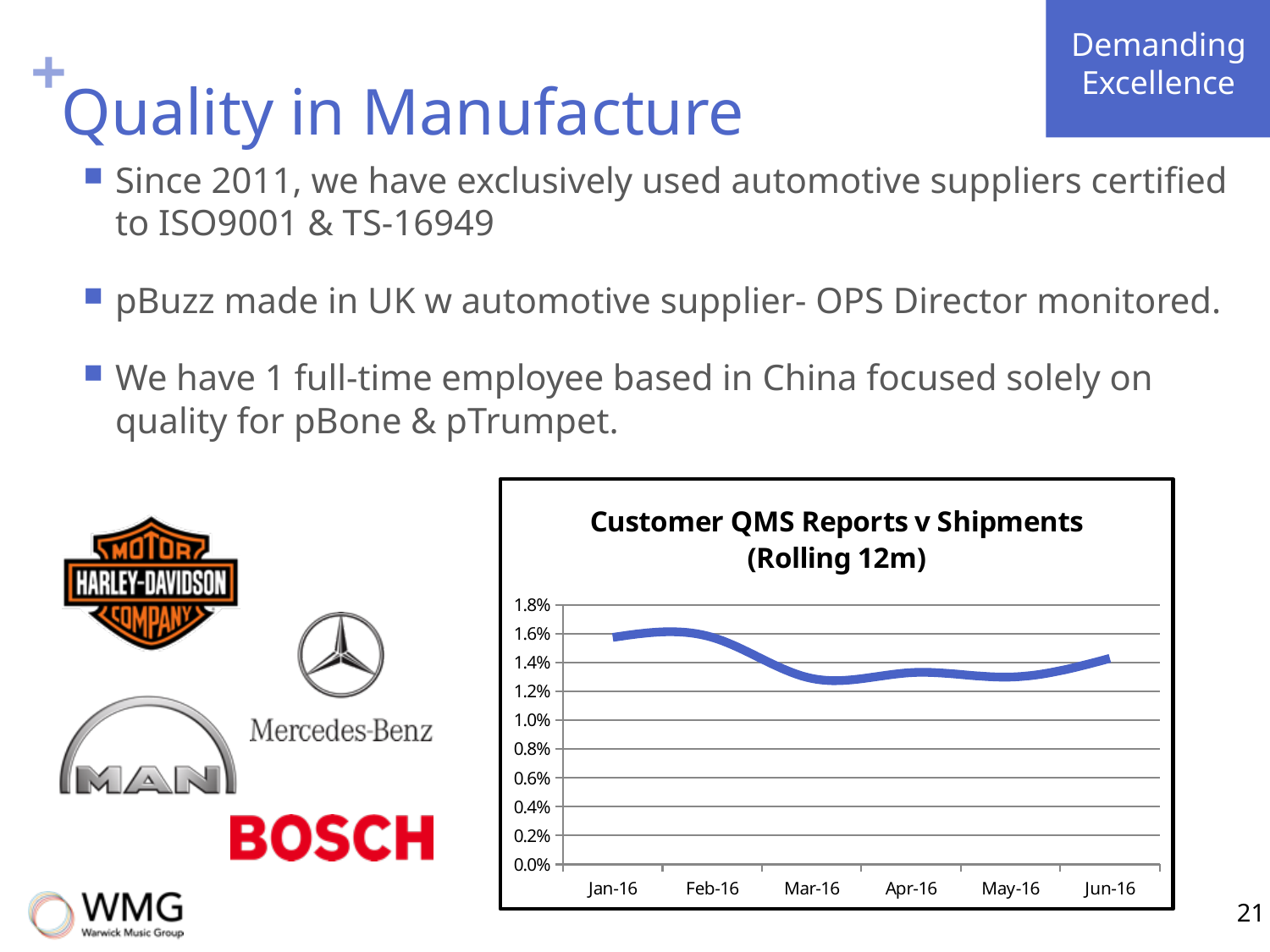
Is the value for Jan-16 greater or less than 1.4%? greater Is the value for Mar-16 greater or less than 1.4%? less Is the value for Apr-16 greater or less than 1.6%? less What kind of chart is shown on the slide? line chart How many months are plotted along the x axis of the chart? 6 What is the title of the chart on the slide? Customer QMS Reports v Shipments (Rolling 12m) Which is larger, the value for Jan-16 or the value for Mar-16? Jan-16 Does the line rise or fall between Jan-16 and Mar-16? fall What is the highest value shown on the y axis of the chart? 1.8% Which is larger, the value for Feb-16 or the value for Jun-16? Feb-16